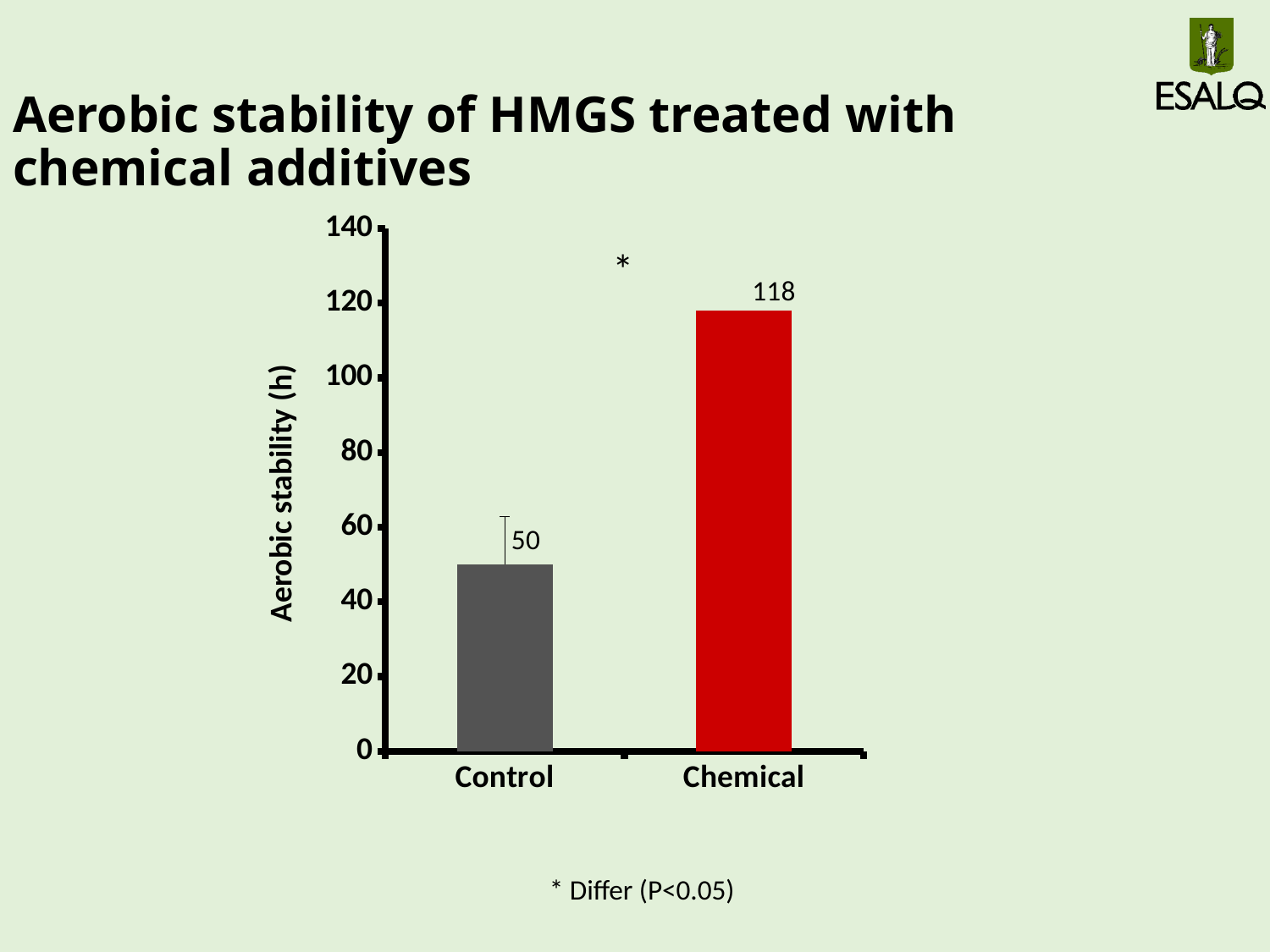
What colour is the bar for the Chemical treatment? Red How many treatments are shown on the chart? 2 What kind of chart is shown on the slide? Bar chart What is the aerobic stability value for the Control treatment? 50 Which has a larger aerobic stability value, Control or Chemical? Chemical Which treatment has the highest aerobic stability? Chemical Is the value for Chemical greater or less than 100? greater Is the value for Control greater or less than 60? less Which treatment has the lowest aerobic stability? Control What is the difference in aerobic stability between the Chemical and Control treatments? 68 What is the label of the vertical axis? Aerobic stability (h) What is the aerobic stability value for the Chemical treatment? 118